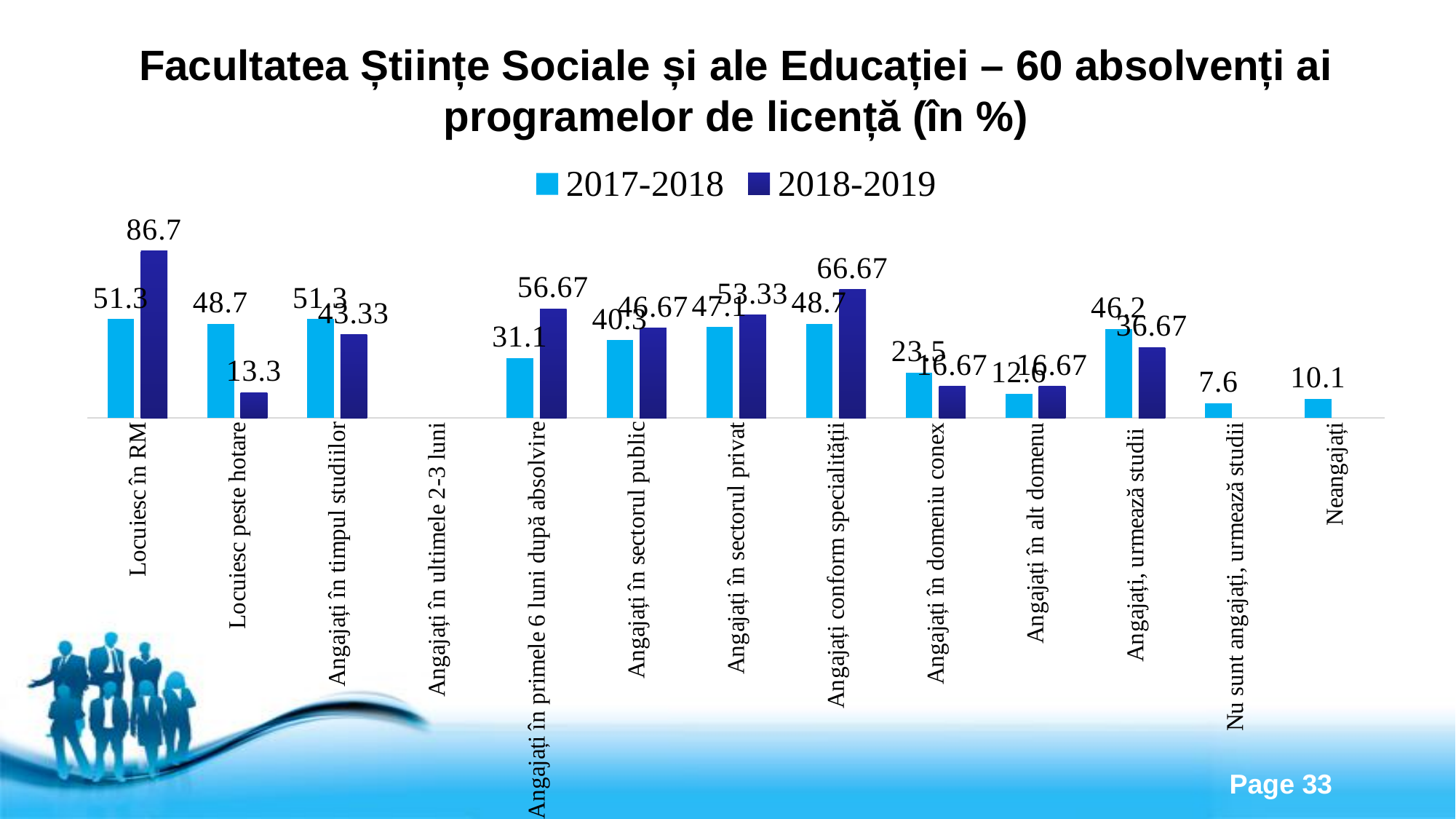
How many series does the legend list? 2 Which category has the lowest value in the 2017-2018 series? Nu sunt angajați, urmează studii What is the difference between the 2018-2019 and 2017-2018 values for "Locuiesc în RM"? 35.4 What is the value for "Angajați în primele 6 luni după absolvire" in the 2017-2018 series? 31.1 What is the value for "Locuiesc în RM" in the 2018-2019 series? 86.7 What is the value for "Neangajați" in the 2017-2018 series? 10.1 What is the value for "Angajați conform specialității" in the 2018-2019 series? 66.67 Which category has the highest value in the 2018-2019 series? Locuiesc în RM What kind of chart is shown on the slide? Bar chart For "Angajați, urmează studii", which series has the larger value, 2017-2018 or 2018-2019? 2017-2018 What is the difference between the 2017-2018 and 2018-2019 values for "Locuiesc peste hotare"? 35.4 How many categories are labelled on the x axis? 13